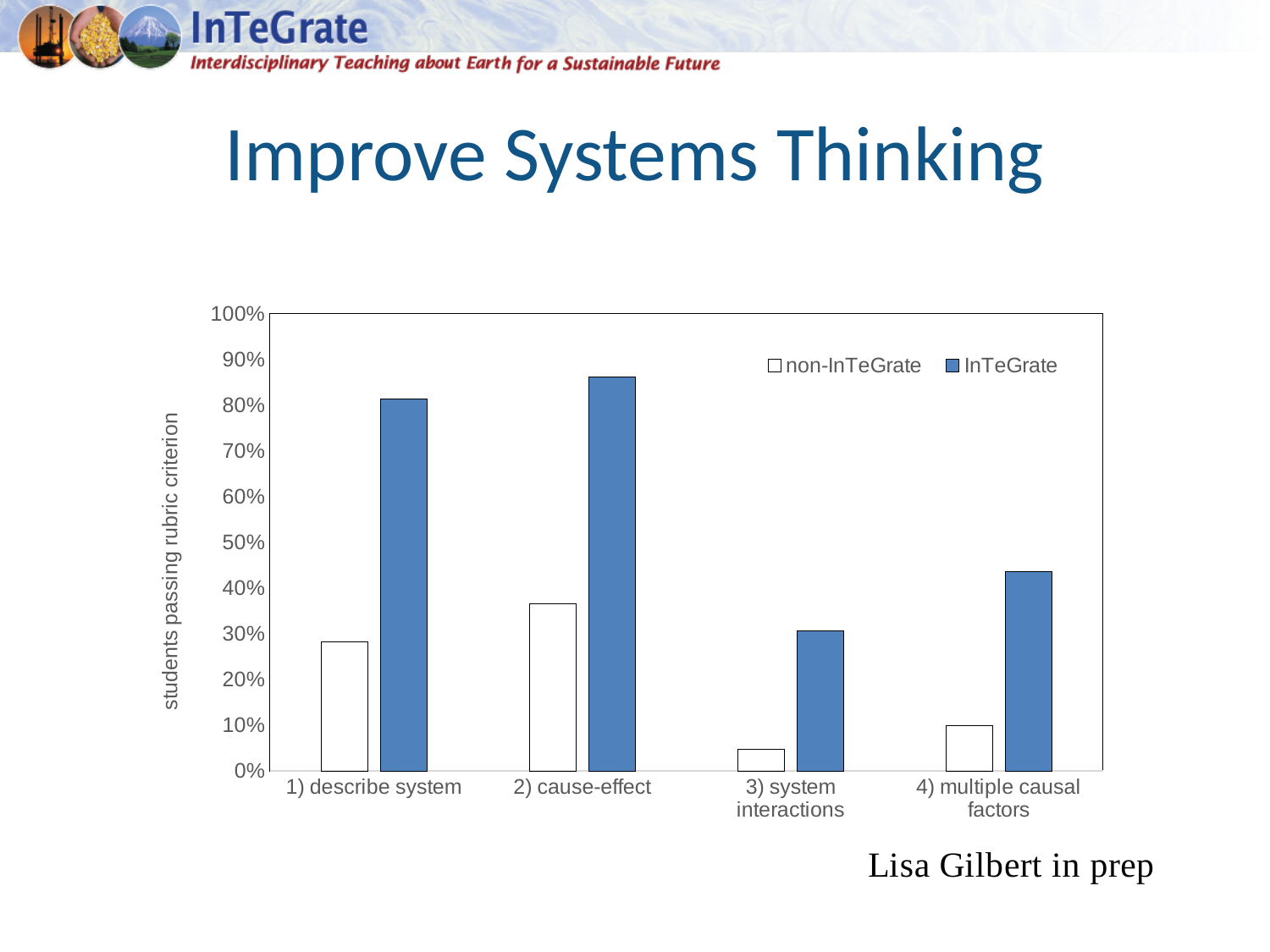
Which category has the highest InTeGrate value? 2) cause-effect How many categories are shown on the x axis? 4 What is the label of the y axis? students passing rubric criterion Is the non-InTeGrate value for 2) cause-effect greater or less than 30%? greater Is the non-InTeGrate value for 3) system interactions greater or less than 10%? less Is the InTeGrate value for 2) cause-effect greater or less than 80%? greater How many series does the legend list? 2 For 1) describe system, which series has the larger value, non-InTeGrate or InTeGrate? InTeGrate Which category has the lowest InTeGrate value? 3) system interactions What kind of chart is shown on the slide? bar chart Which category has the lowest non-InTeGrate value? 3) system interactions